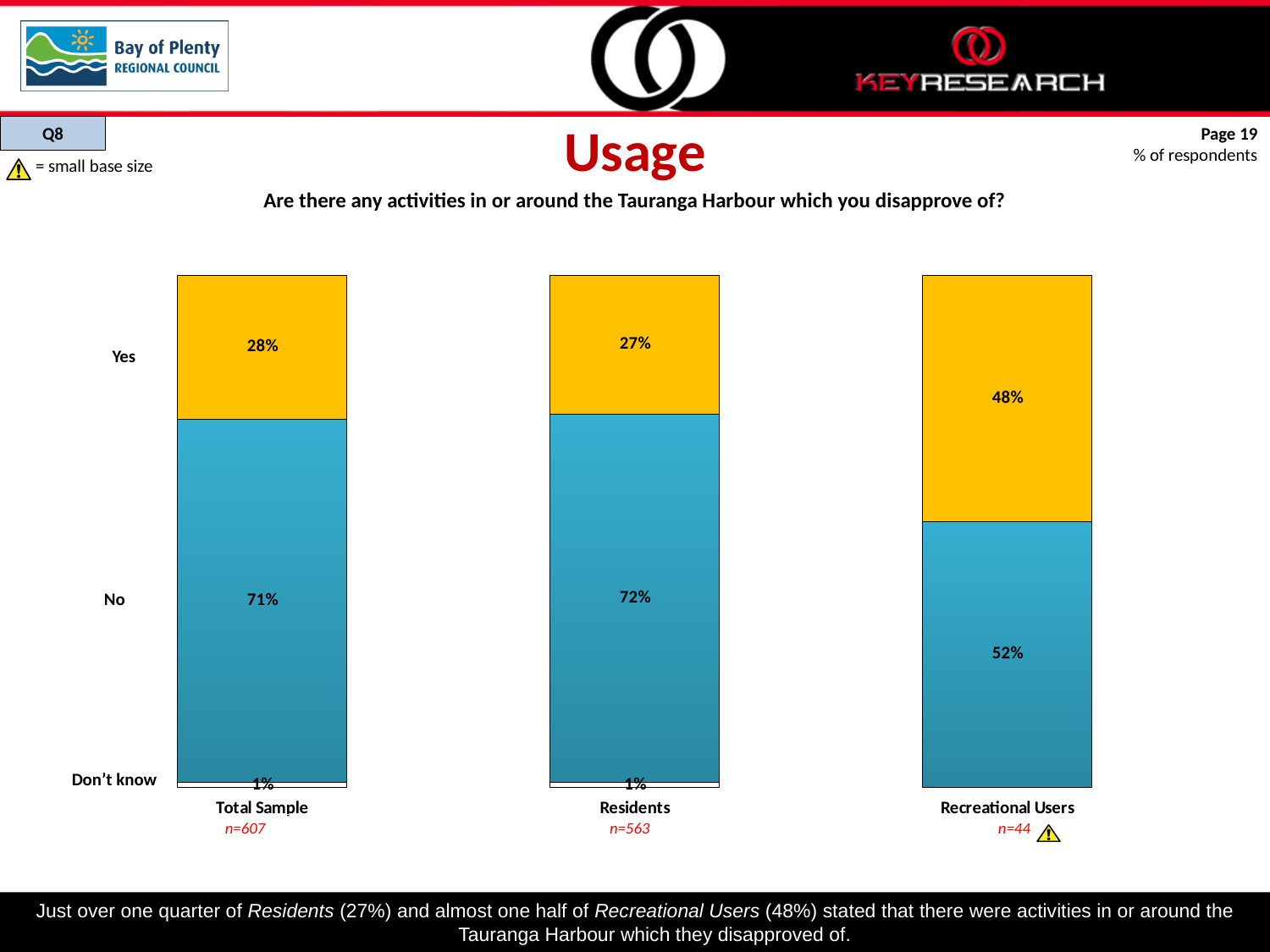
What percentage of Recreational Users answered No? 52% How many groups (bars) are shown in the chart? 3 Which group has the lowest percentage answering No? Recreational Users What type of chart is shown on the slide? Stacked bar chart What percentage of Residents answered Don't know? 1% What is the sample size (n) for the Recreational Users group? n=44 What percentage of Recreational Users answered Yes? 48% Which group has the highest percentage answering Yes? Recreational Users Which is larger: the No percentage for the Total Sample or the No percentage for Residents? Residents What percentage of the Total Sample answered Yes? 28% What percentage of Residents answered No? 72% What is the difference between the Yes percentage for Recreational Users and the Yes percentage for Residents? 21%